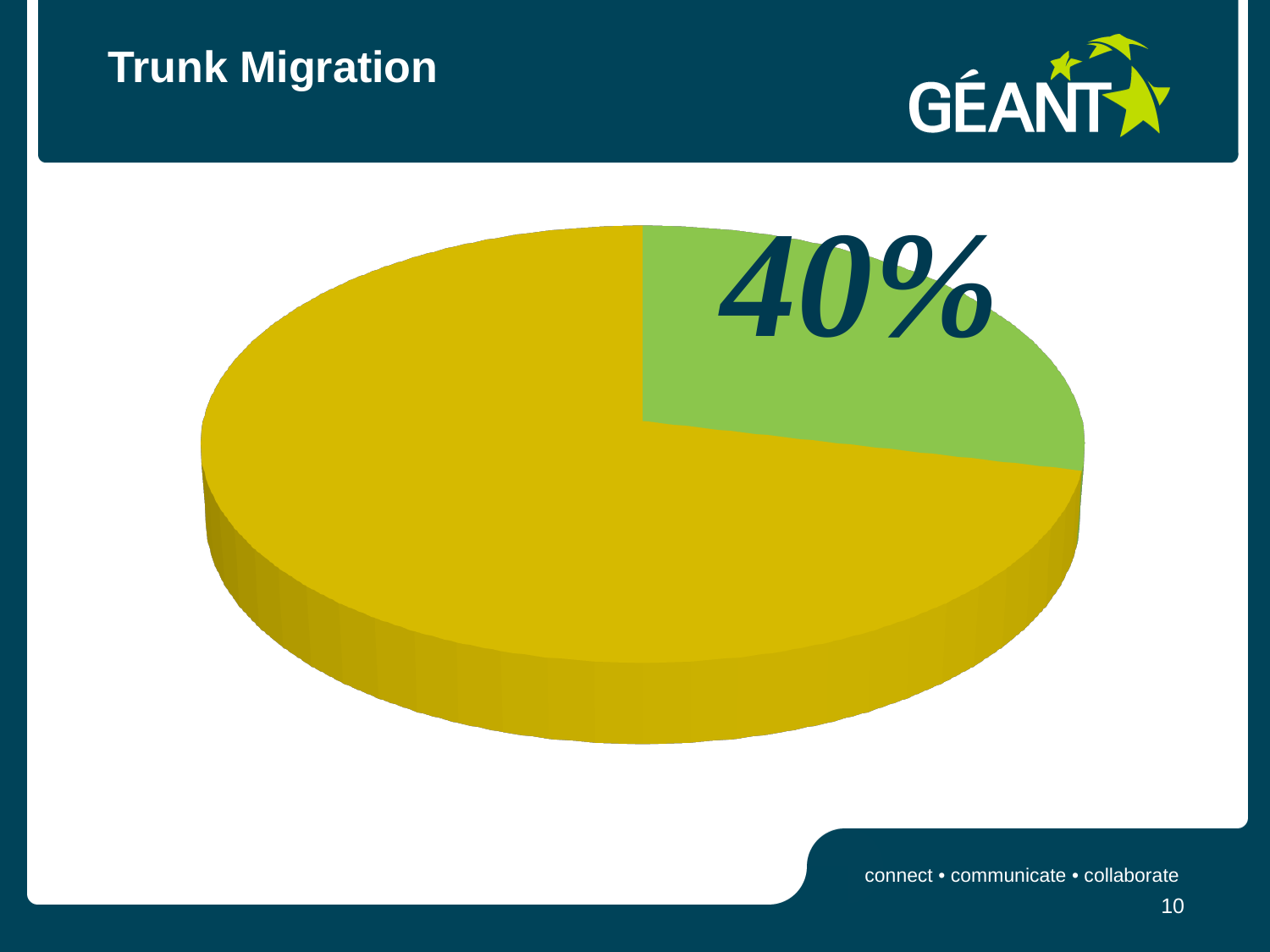
Which colour slice is the largest in the pie chart? yellow What kind of chart is shown on the slide? pie chart What percentage is printed on the green slice of the pie chart? 40% Which colour slice is the smallest in the pie chart? green What is the title of the slide containing the pie chart? Trunk Migration What two colours are used for the slices of the pie chart? yellow and green How many slices does the pie chart have? 2 Which slice of the pie chart is larger, the yellow one or the green one? yellow